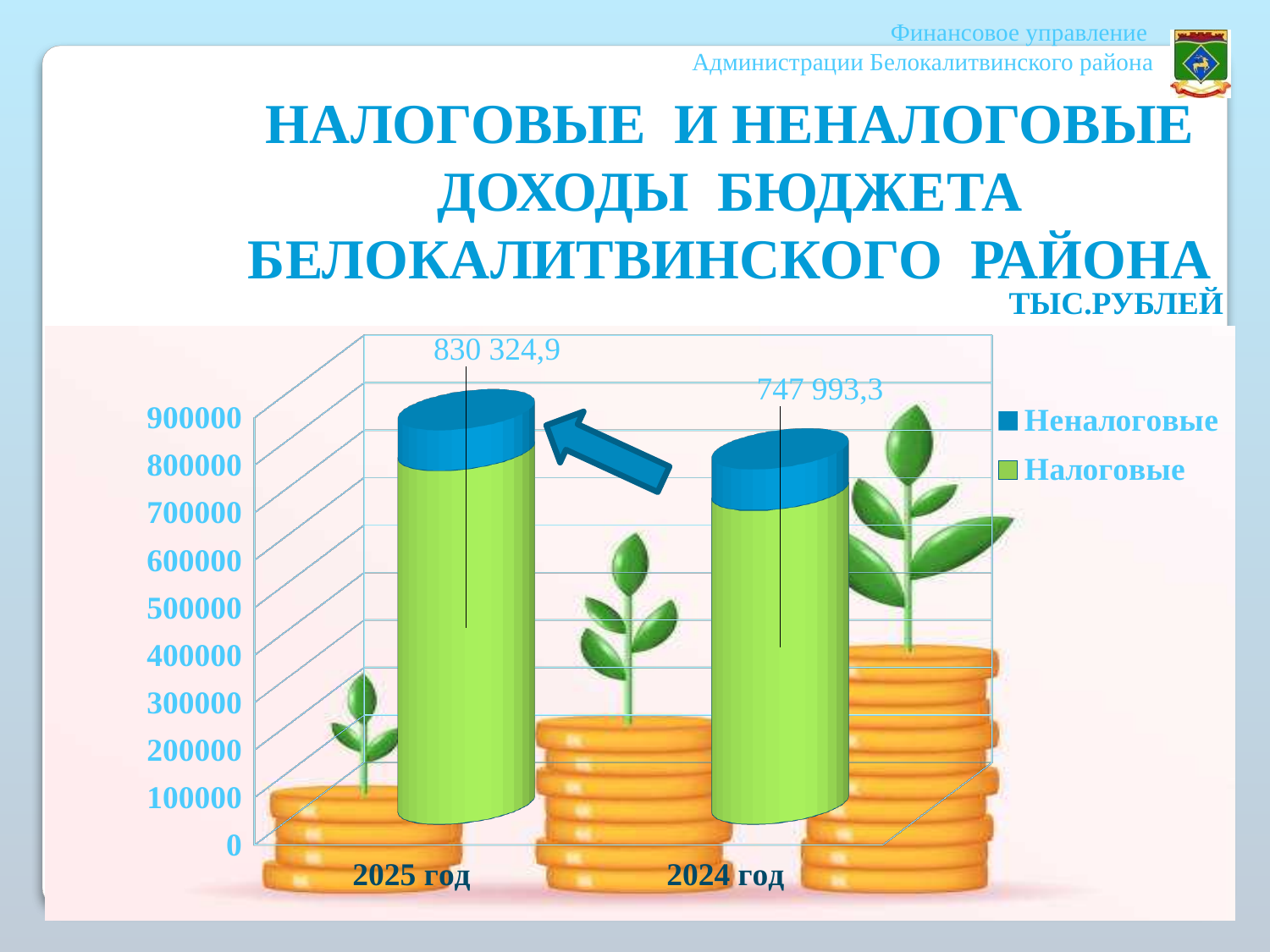
Which colour represents the Неналоговые series in the legend? Blue Is the labelled value for 2024 год greater or less than 800000? less What is the difference between the labelled values for 2025 год and 2024 год? 82 331,6 What value is labelled for 2025 год? 830 324,9 How many series does the legend list? 2 What value is labelled for 2024 год? 747 993,3 Which year has the higher labelled value, 2025 год or 2024 год? 2025 год Is the Налоговые portion of the 2025 год bar greater or less than 600000? greater Do the labelled values rise or fall from 2025 год to 2024 год along the x axis? fall What kind of chart is shown on the slide? Stacked bar chart How many categories are shown on the x axis? 2 Which category has the lowest labelled value? 2024 год